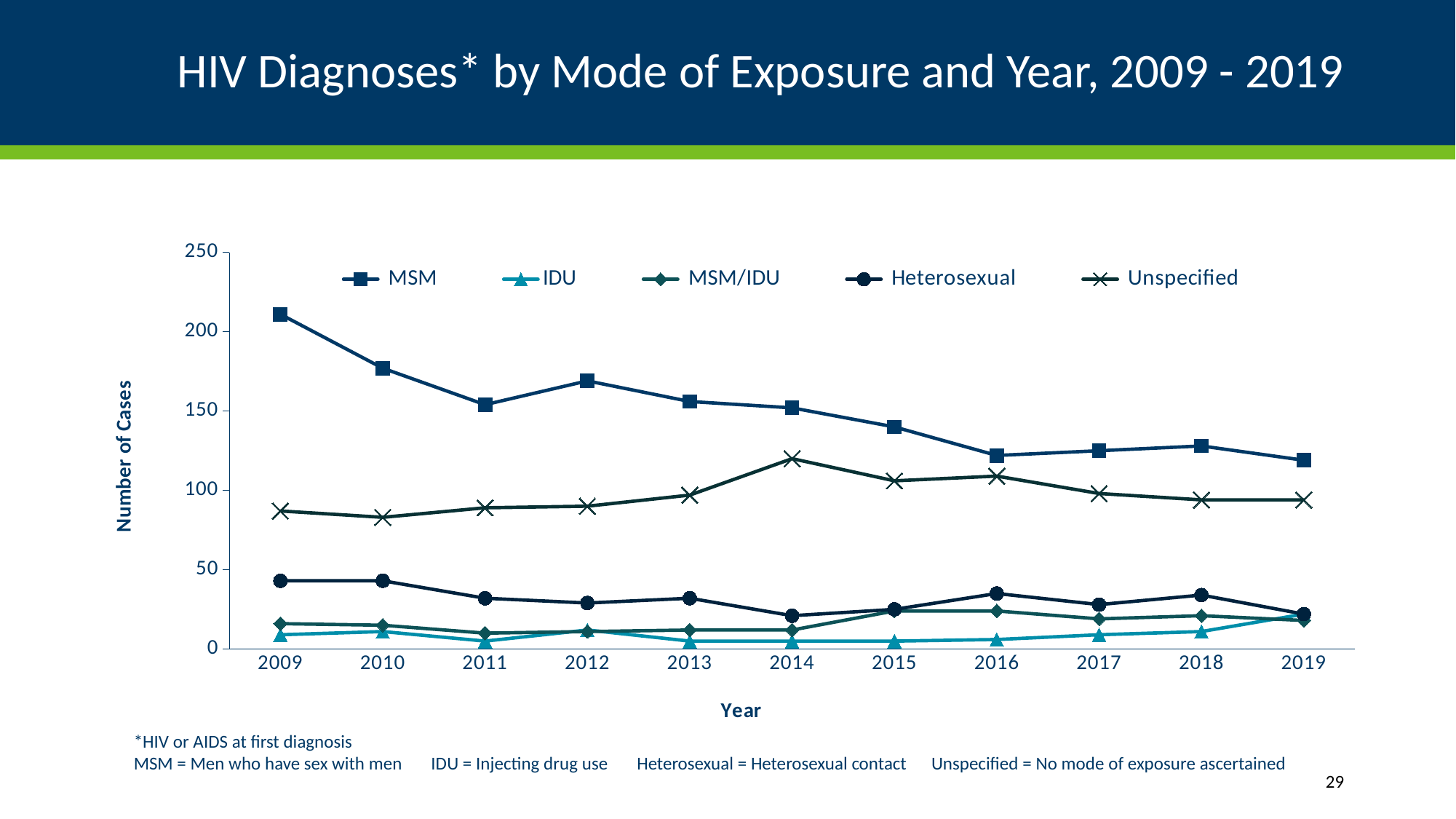
How many years are plotted along the x axis? 11 Which mode of exposure has the highest number of cases in 2009? MSM What kind of chart is shown on the slide? line chart Which mode of exposure has the lowest number of cases in 2013? IDU What is the title of the y axis? Number of Cases In which year does the Unspecified series reach its highest value? 2014 Do the MSM values overall rise or fall from 2009 to 2019? fall Is the value for MSM in 2009 greater or less than 200? greater Is the value for Heterosexual in 2009 greater or less than 50? less Is the value for Unspecified in 2014 greater or less than 100? greater How many series does the legend list? 5